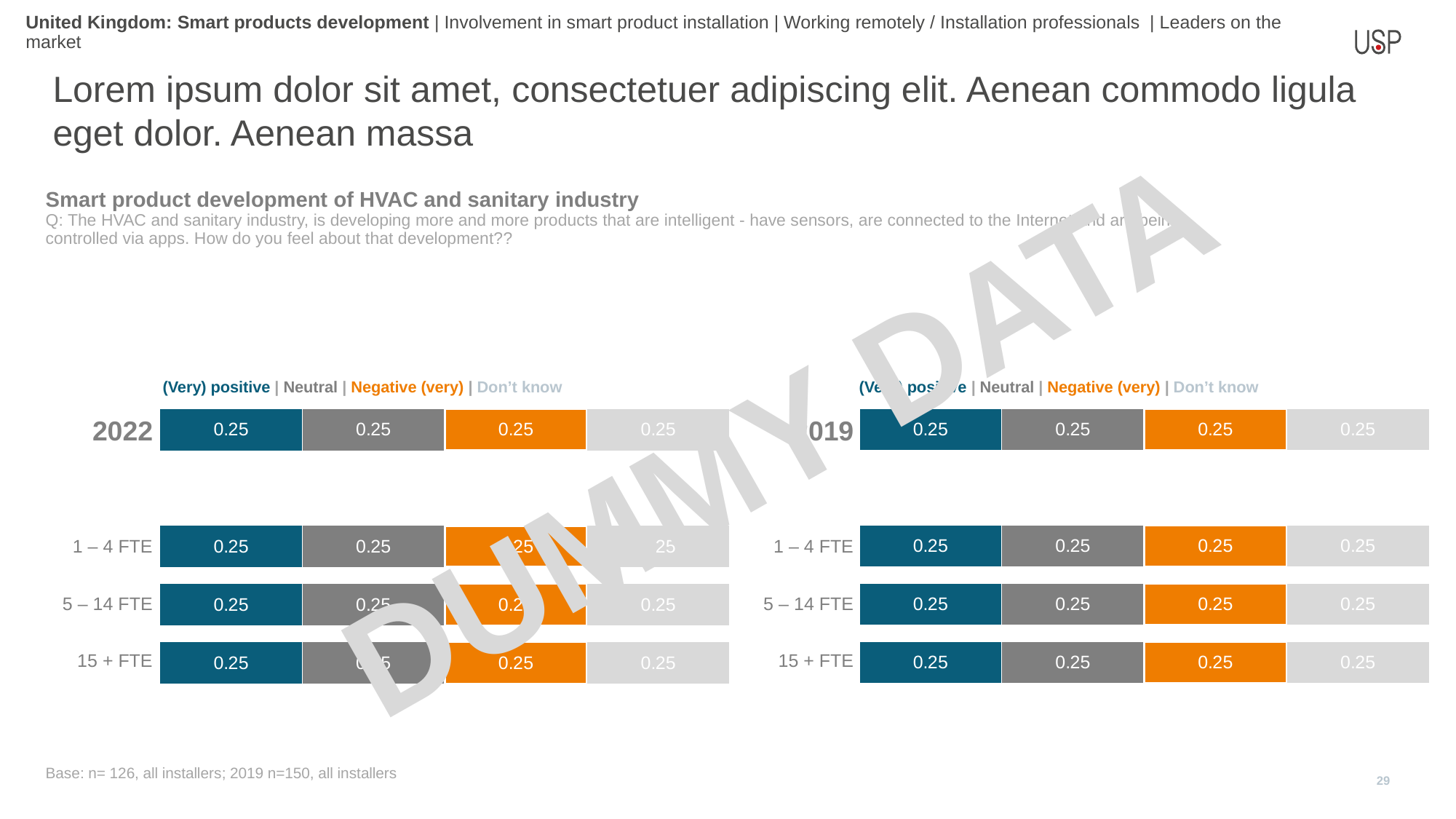
In the left-hand chart, what is the value for (Very) positive in the 2022 row? 0.25 What is the title of the chart section on the slide? Smart product development of HVAC and sanitary industry What kind of chart is the left-hand chart? Stacked bar chart In the left-hand chart, what is the total of the stacked bar for 15 + FTE? 1 In the right-hand chart, what is the value for Don't know in the 1 – 4 FTE row? 0.25 In the left-hand chart, which colour represents Negative (very)? Orange In the left-hand chart, what is the difference between the (Very) positive and Negative (very) values in the 1 – 4 FTE row? 0 How many FTE size categories are shown in the right-hand chart, excluding the overall row? 3 In the right-hand chart, what is the total of the stacked bar for 5 – 14 FTE? 1 In the left-hand chart, what is the value for Neutral in the 5 – 14 FTE row? 0.25 In the right-hand chart, what is the value for Negative (very) in the 15 + FTE row? 0.25 How many series does the legend of the left-hand chart list? 4